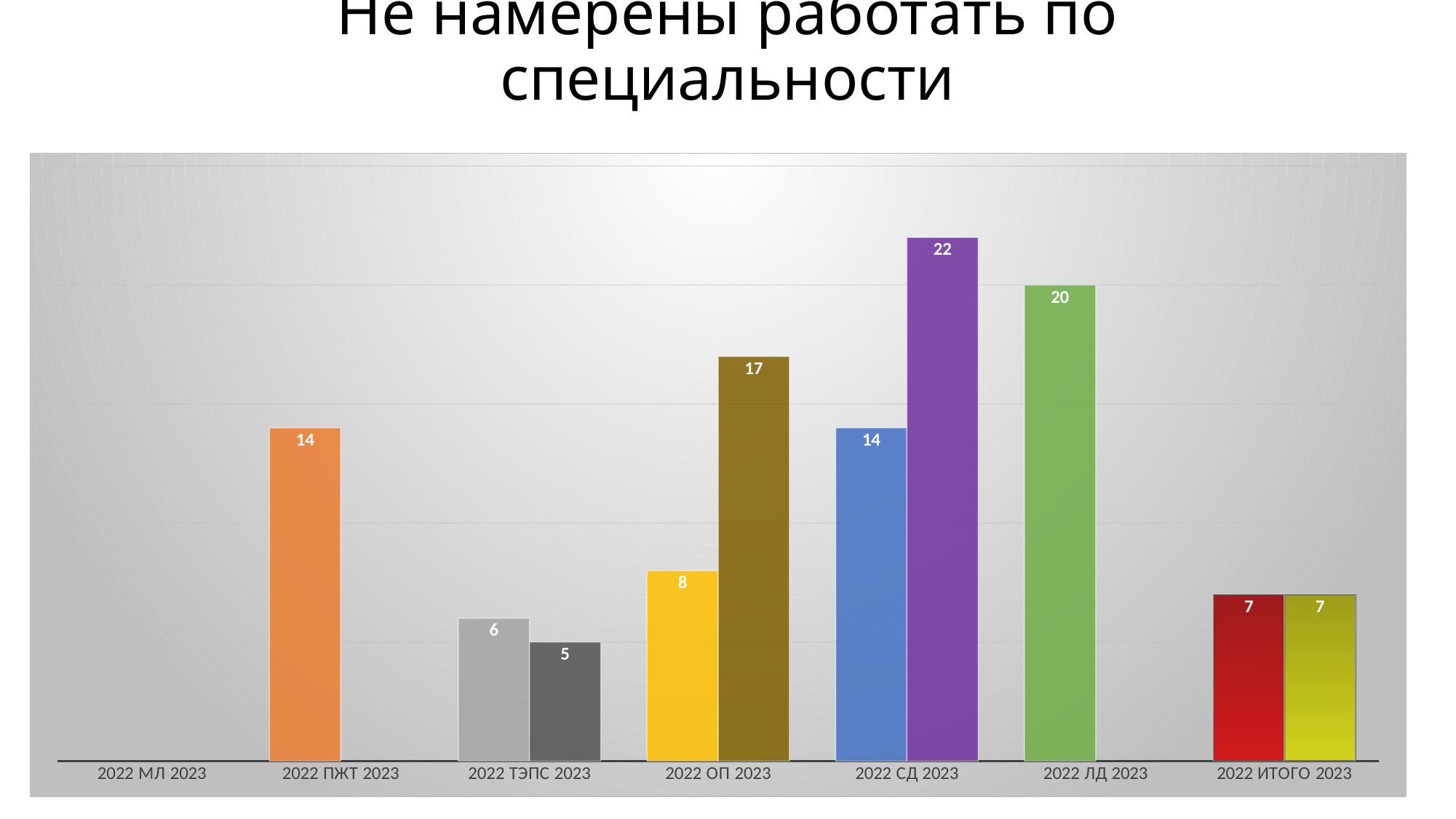
What is the value of the green bar for ЛД? 20 Which is larger for ТЭПС: the 2022 bar or the 2023 bar? 2022 What is the title of the chart? Не намерены работать по специальности What is the value of the 2023 bar for ОП? 17 What is the difference between the 2023 and 2022 bars for СД? 8 What is the value of the shortest labelled bar in the chart? 5 What is the value of the tallest bar in the chart? 22 What is the value of the orange bar for ПЖТ? 14 What are the values of the two bars for ИТОГО? 7 and 7 What is the value of the 2022 bar for ОП? 8 What type of chart is shown on the slide? bar chart Which group contains the tallest bar? СД